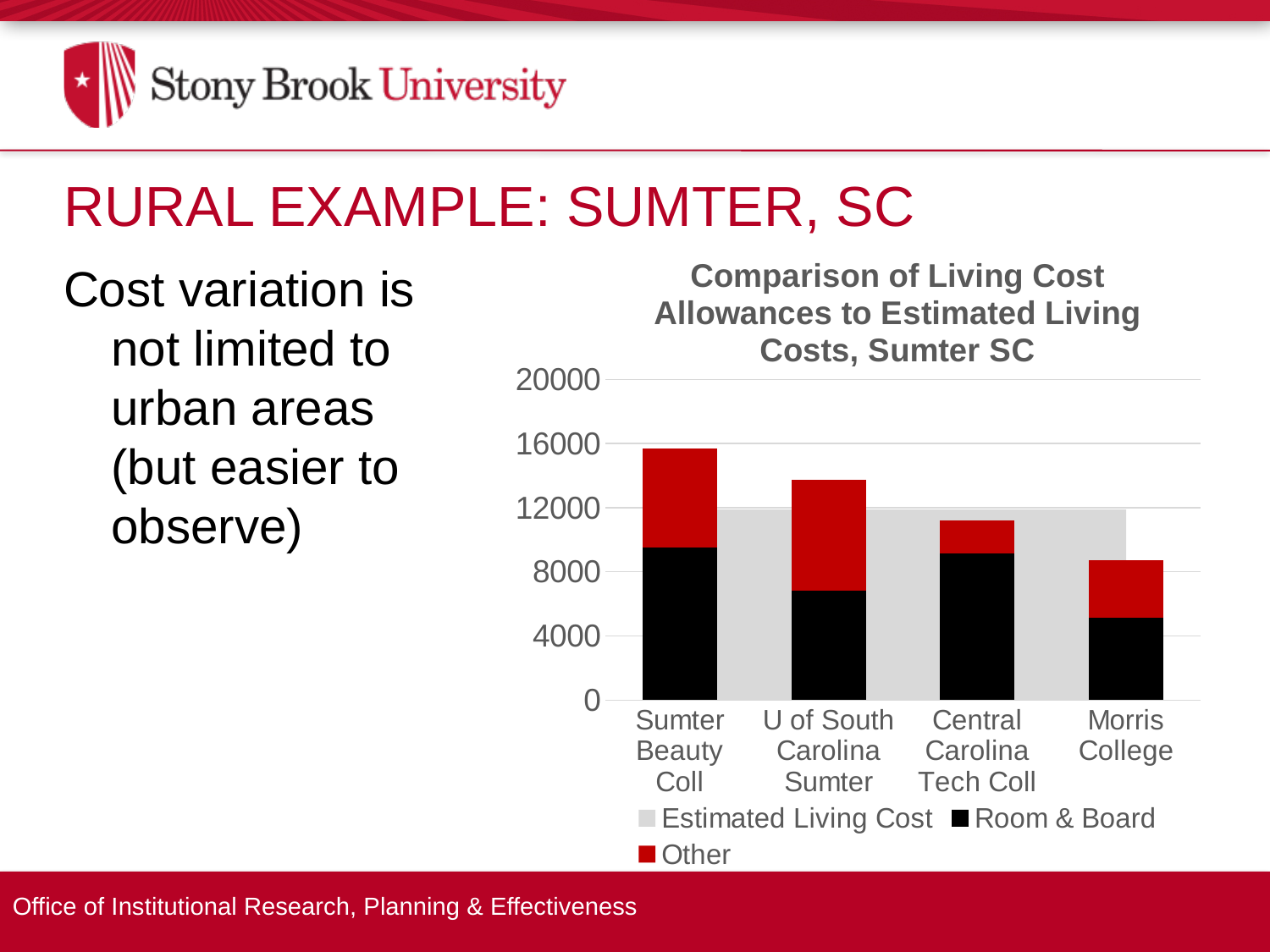
Is the total stacked bar for Morris College greater or less than 12000? less Is the total stacked bar for Sumter Beauty Coll greater or less than 12000? greater Which college has the highest total stacked bar (Room & Board plus Other)? Sumter Beauty Coll Which has the larger Room & Board value, Sumter Beauty Coll or U of South Carolina Sumter? Sumter Beauty Coll What is the title of the chart? Comparison of Living Cost Allowances to Estimated Living Costs, Sumter SC How many series does the chart legend list? 3 Is the Room & Board value for U of South Carolina Sumter greater or less than 8000? less What kind of chart is shown on the slide? Stacked bar chart How many colleges are shown on the x axis of the chart? 4 Which college has the lowest total stacked bar (Room & Board plus Other)? Morris College Do the total stacked bars rise or fall moving from left to right across the colleges? fall